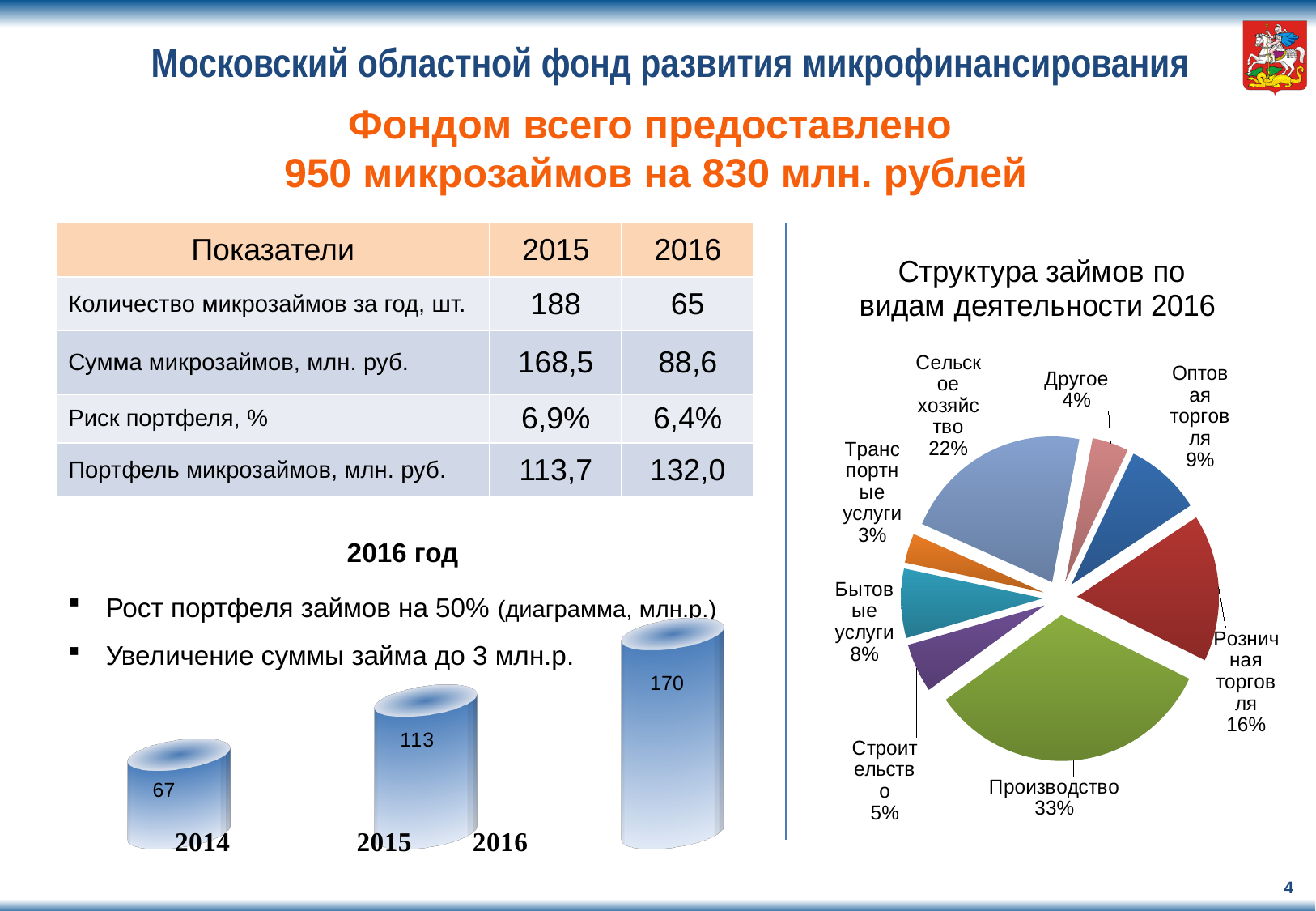
In the pie chart 'Структура займов по видам деятельности 2016', how many slices are there? 8 What kind of chart is the one titled 'Структура займов по видам деятельности 2016'? pie chart In the pie chart 'Структура займов по видам деятельности 2016', what share does Производство have? 33% In the bar chart at the bottom left, do the values rise or fall from 2014 to 2016? rise In the bar chart at the bottom left, what is the value for 2014? 67 In the pie chart 'Структура займов по видам деятельности 2016', which is larger: Оптовая торговля or Розничная торговля? Розничная торговля In the pie chart 'Структура займов по видам деятельности 2016', which category has the smallest share? Транспортные услуги In the bar chart at the bottom left, which year has the highest value? 2016 In the bar chart at the bottom left, what is the value for 2016? 170 In the bar chart at the bottom left, how many bars are shown? 3 In the pie chart 'Структура займов по видам деятельности 2016', what share does Сельское хозяйство have? 22% In the bar chart at the bottom left, what is the difference between the 2016 and 2015 values? 57